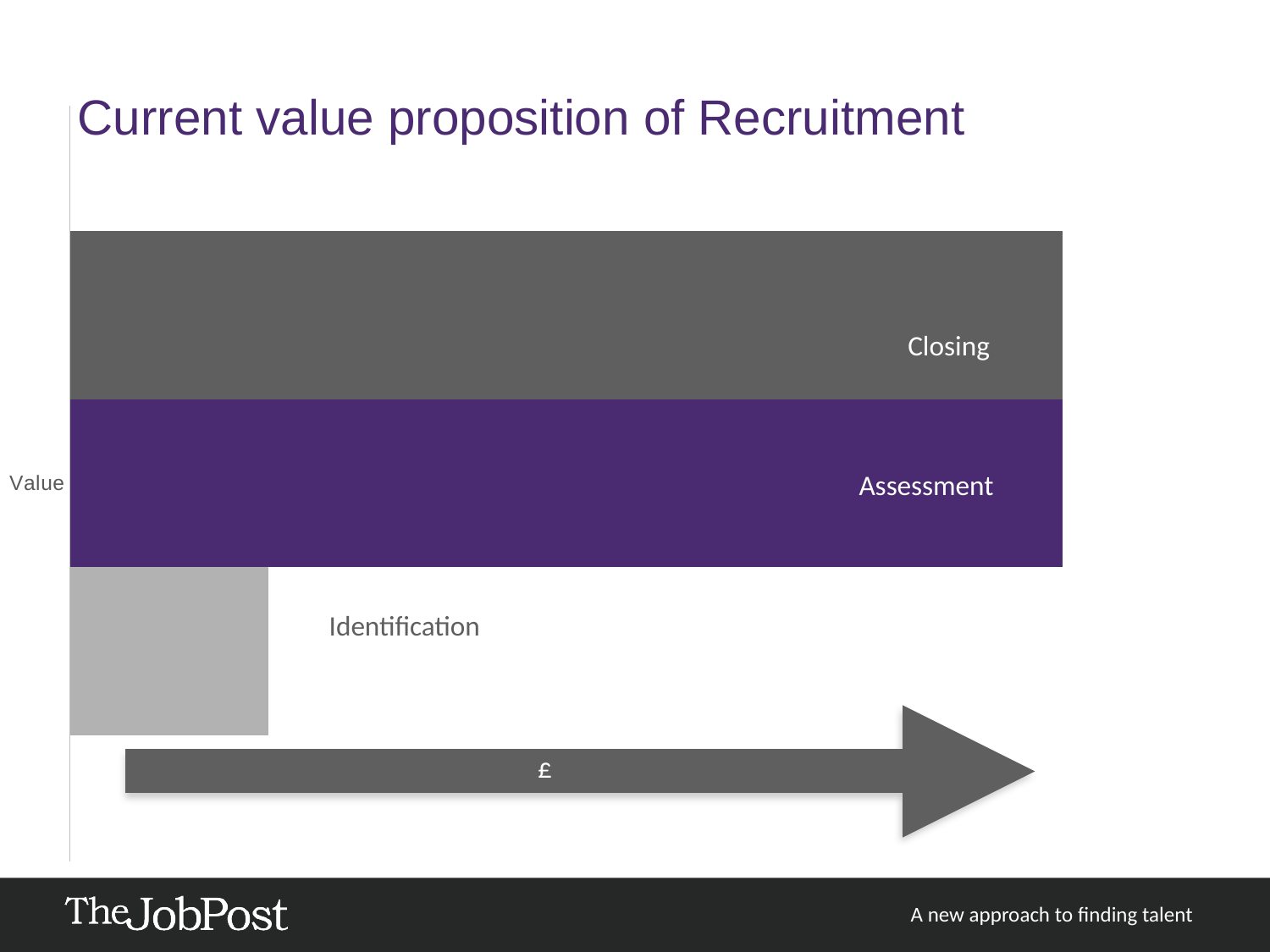
What kind of chart is shown on the slide? bar chart Which bar is longer, Closing or Identification? Closing Which category has the shortest bar in the chart? Identification What is the title of the chart on the slide? Current value proposition of Recruitment How many bars (categories) does the chart show? 3 What are the names of the three categories shown in the chart, from top to bottom? Closing, Assessment, Identification Which bar is longer, Assessment or Identification? Assessment What label appears on the vertical axis of the chart? Value